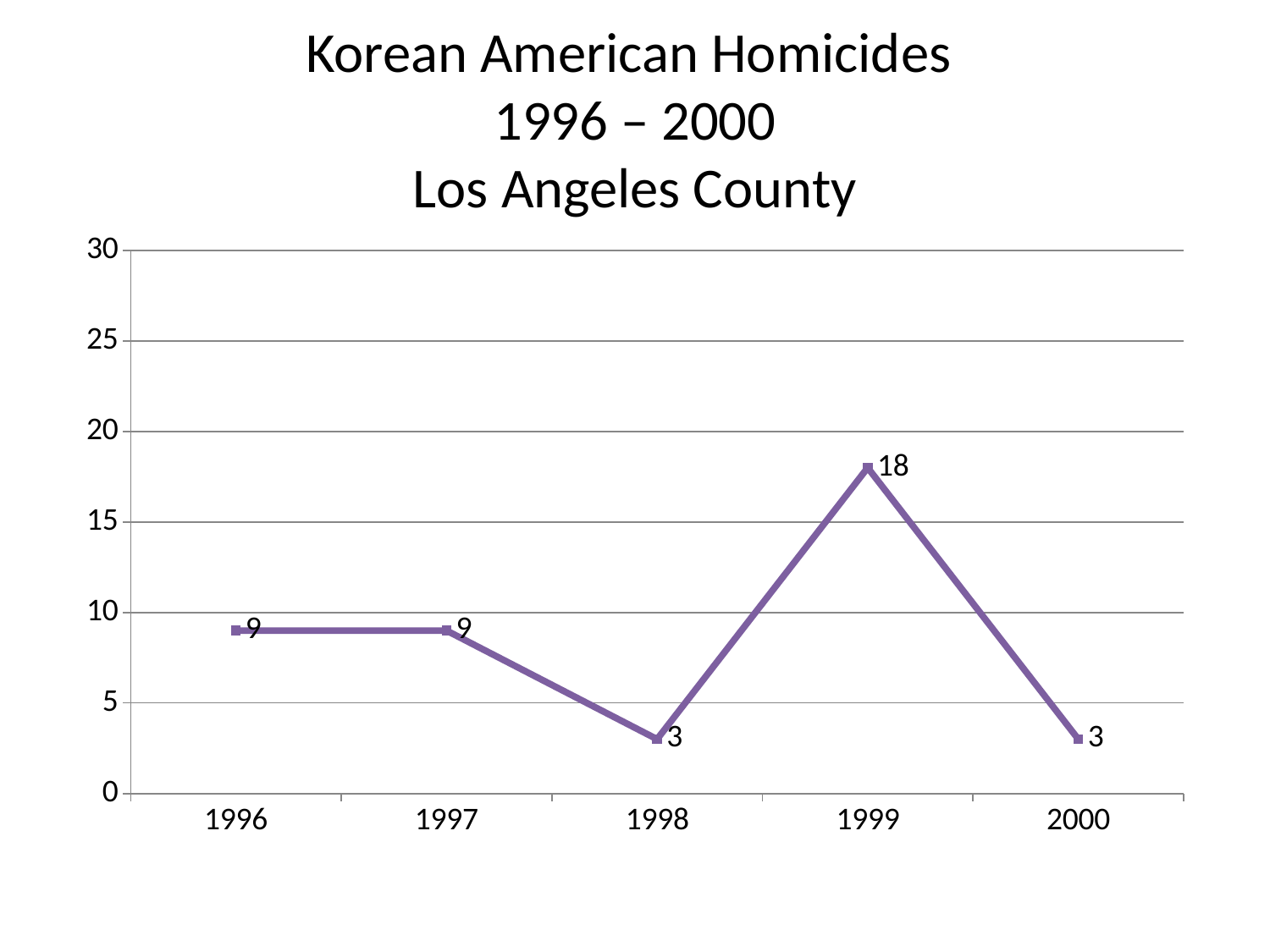
Which is larger, the value for 1997 or the value for 2000? 1997 Does the value rise or fall from 1999 to 2000? fall Is the value for 1999 greater or less than 15? greater Which year has the highest value? 1999 What is the difference between the values for 1997 and 1998? 6 What is the title of the chart? Korean American Homicides 1996 – 2000 Los Angeles County What is the value for 1999? 18 What kind of chart is shown on the slide? line chart What is the value for 2000? 3 What is the value for 1996? 9 What is the difference between the values for 1999 and 1998? 15 How many years are plotted on the x axis? 5